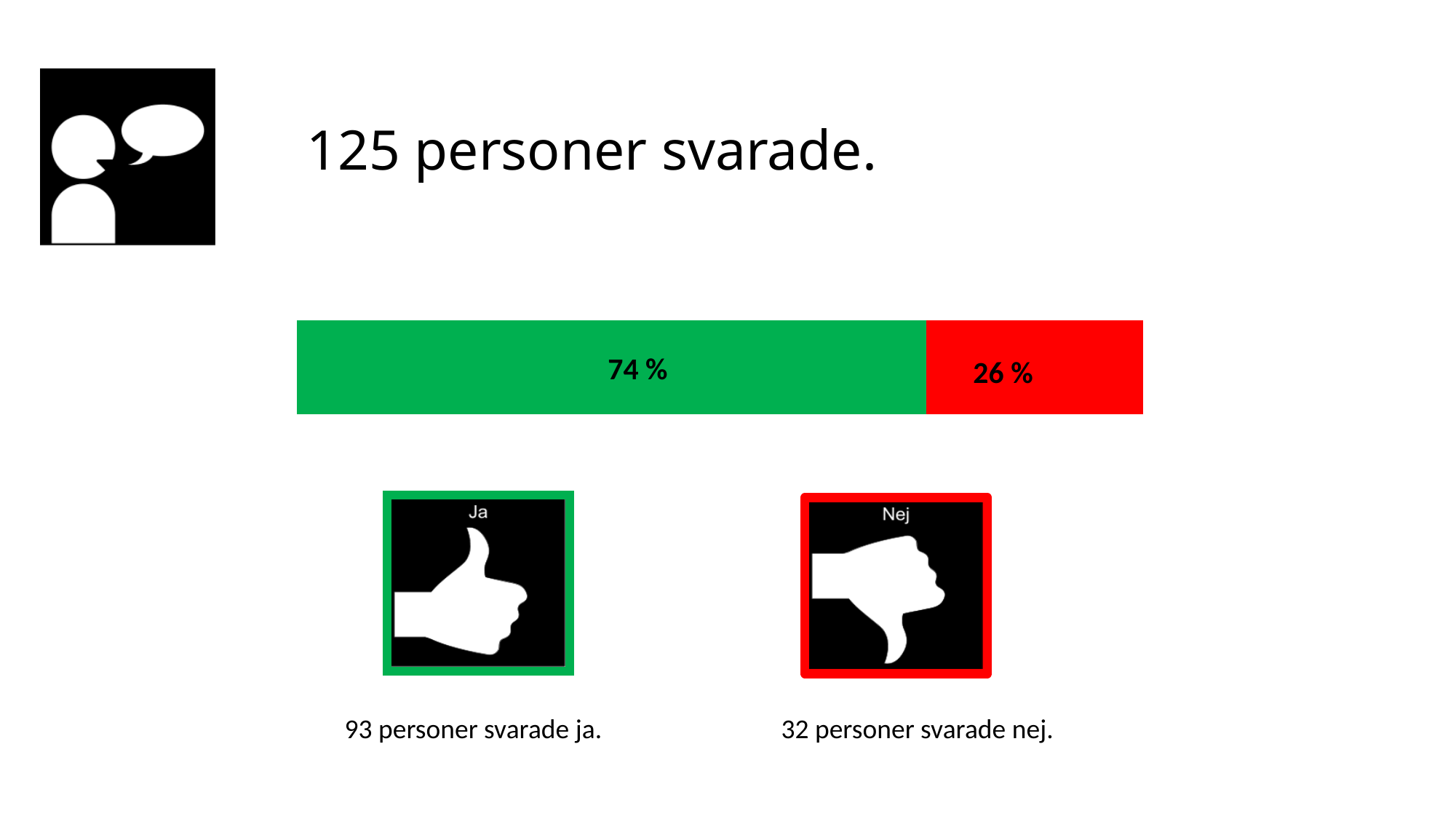
Which segment of the bar is larger, the green one or the red one? the green one What colour is the segment labelled 74 %? green How many segments does the bar have? 2 What percentage is shown on the red segment of the bar? 26 % What is the total of the two segments in the stacked bar? 100 % What is the difference in percentage points between the green segment and the red segment? 48 Which segment of the bar has the smallest value? the red segment (26 %) Is the value of the green segment greater or less than 50 %? greater What is the title text above the bar chart? 125 personer svarade. What kind of chart is shown on the slide? a stacked horizontal bar chart What percentage is shown on the green segment of the bar? 74 %